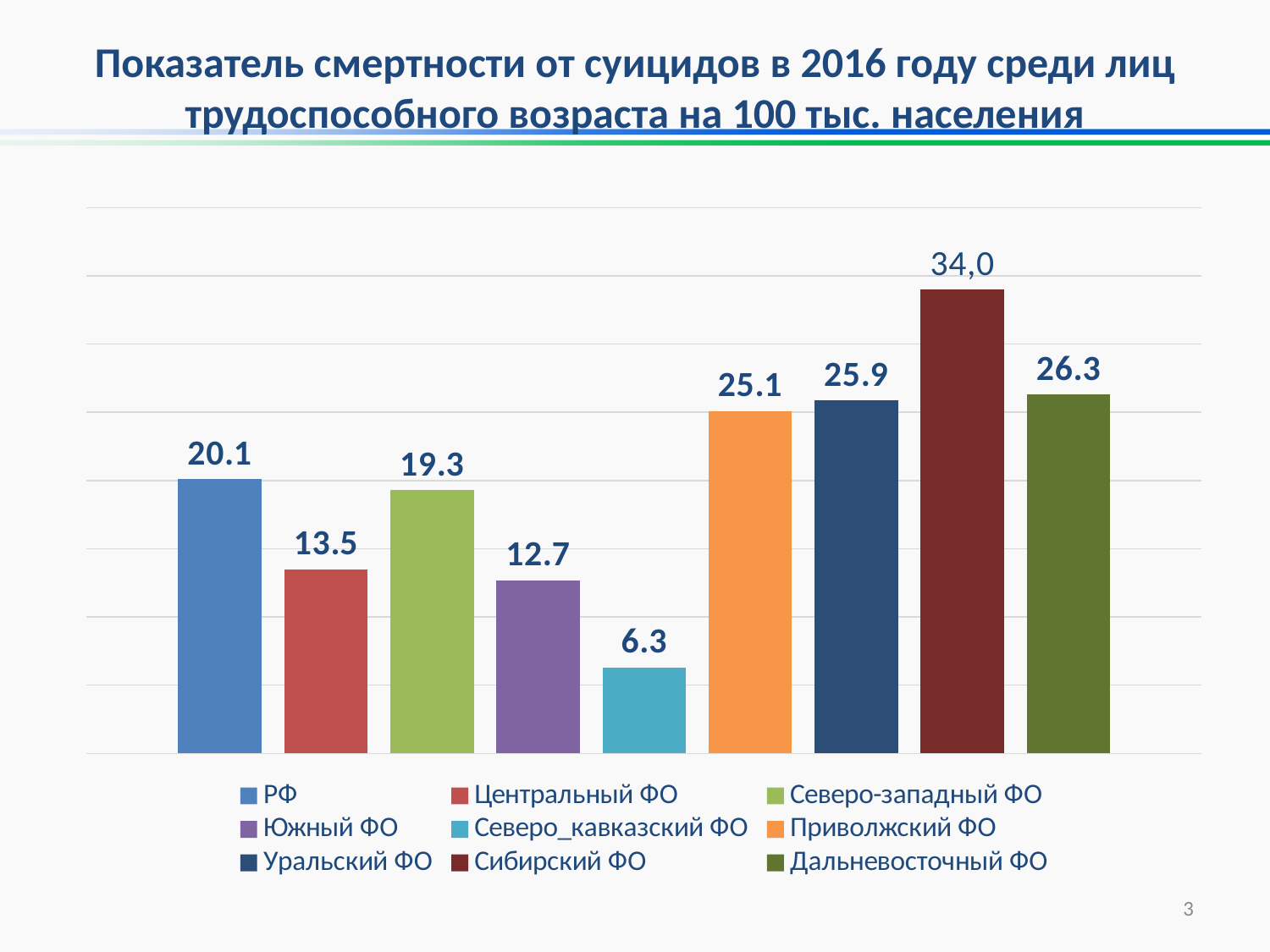
What is the value for РФ? 20.1 How many entries does the legend list? 9 Which federal district has the lowest value? Северо_кавказский ФО How many bars are plotted on the chart? 9 What is the value for Сибирский ФО? 34,0 What is the value for Северо_кавказский ФО? 6.3 Which federal district has the highest value? Сибирский ФО Which is larger, the value for Южный ФО or the value for Северо-западный ФО? Северо-западный ФО What kind of chart is shown on the slide? bar chart What is the value for Приволжский ФО? 25.1 What is the difference between the values for РФ and Центральный ФО? 6.6 What is the difference between the values for Сибирский ФО and Северо_кавказский ФО? 27.7